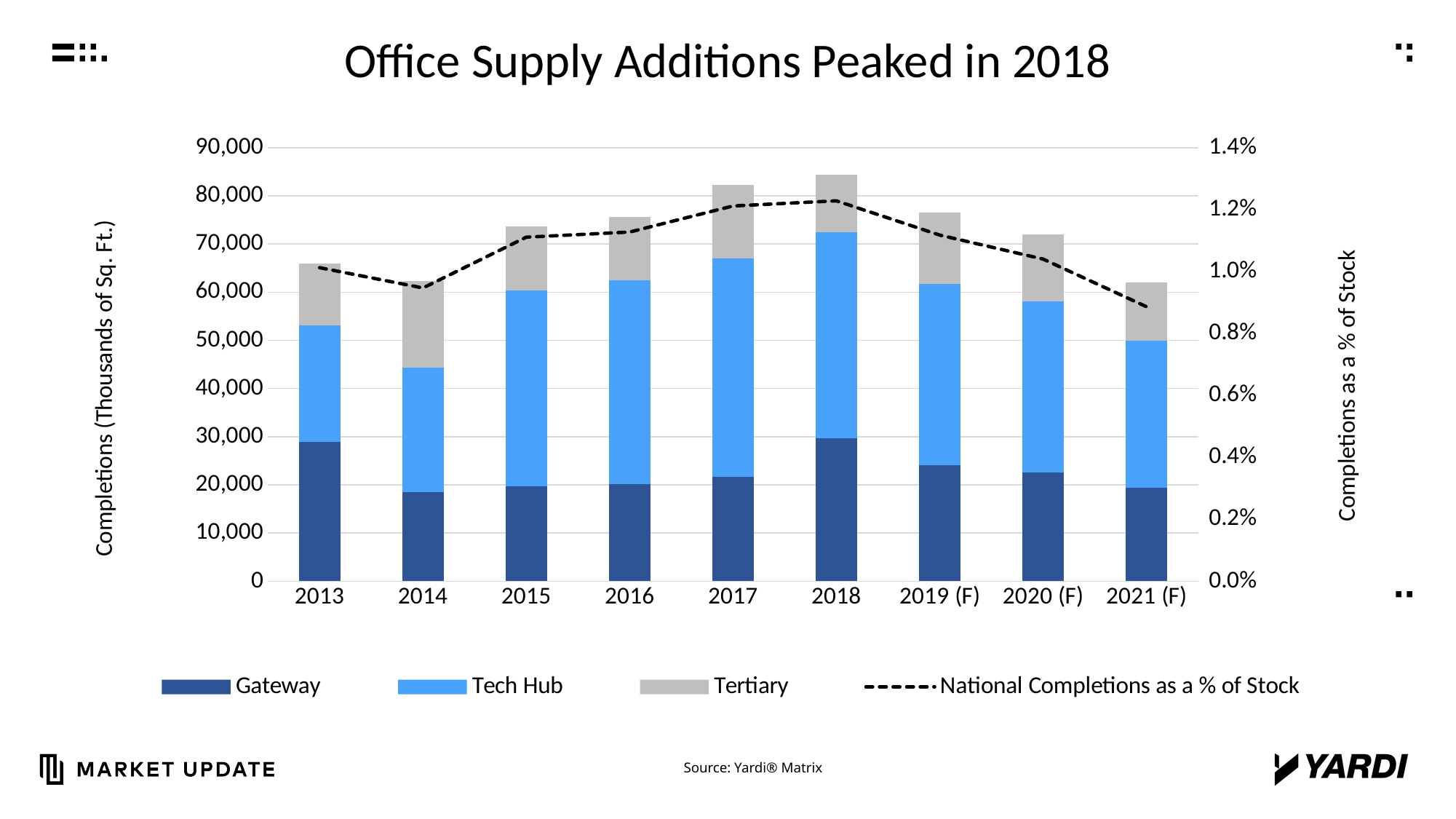
How many years are shown on the x axis? 9 Do total completions rise or fall from 2018 to 2021 (F)? fall Is the total completions bar for 2014 greater or less than 70,000? less Which year has a larger total completions bar, 2017 or 2014? 2017 Is the total completions bar for 2018 greater or less than 80,000? greater Is the National Completions as a % of Stock value for 2021 (F) greater or less than 1.0%? less What kind of chart is this? Stacked bar chart with a line Which year has the highest total office completions? 2018 Which year has the lowest value for National Completions as a % of Stock? 2021 (F) How many series does the legend list? 4